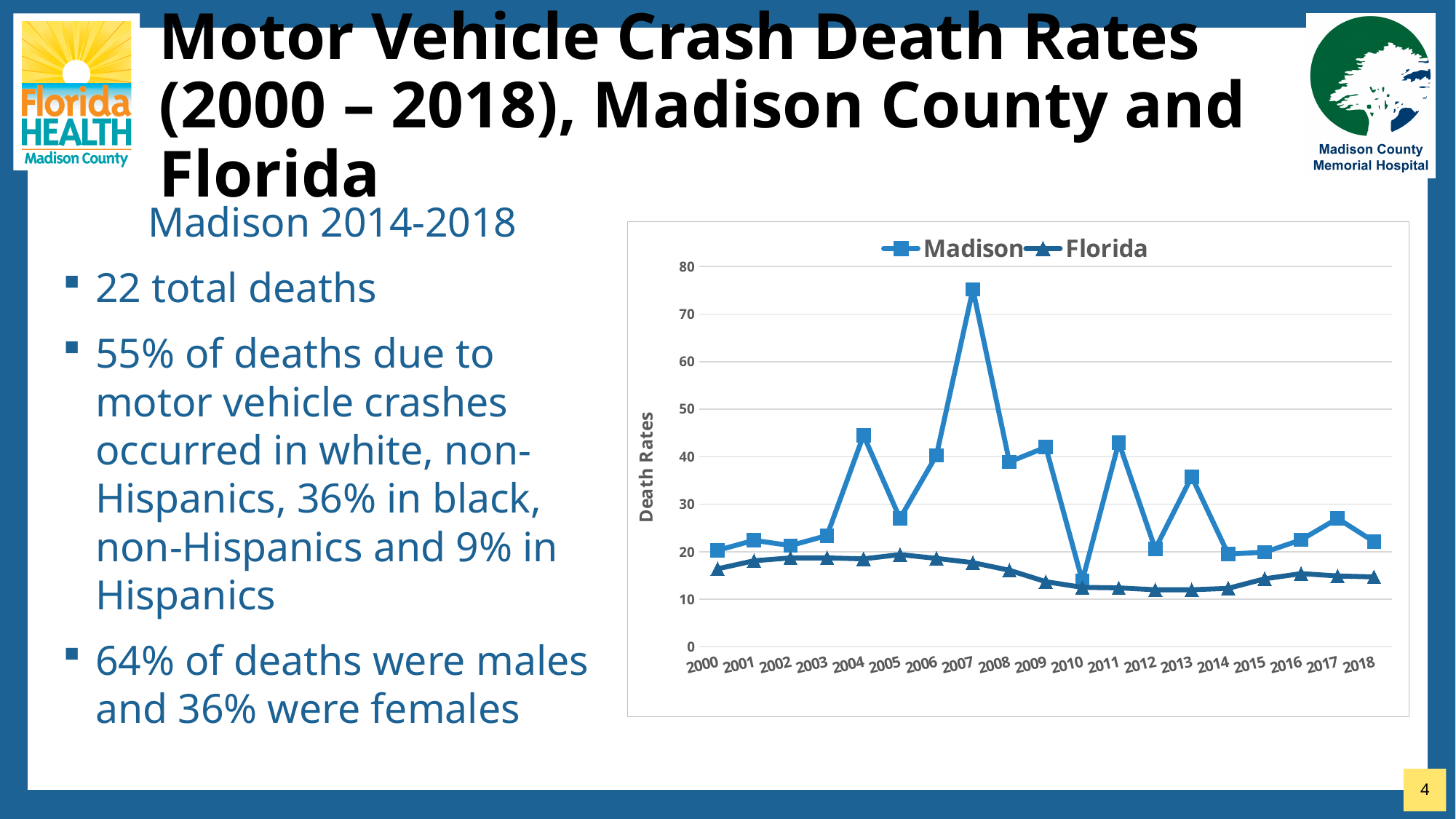
Which series has the higher death rate in 2007, Madison or Florida? Madison How many years are plotted along the x axis of the chart? 19 In which year does the Madison series reach its highest death rate? 2007 What kind of chart is shown on the slide? line chart What is the label on the chart's y axis? Death Rates Is the Madison death rate in 2004 greater or less than 40? greater Does the Florida death rate rise or fall between 2005 and 2012? fall Which series is drawn with triangle markers? Florida How many series does the chart's legend list? 2 Is the Madison death rate in 2007 greater or less than 70? greater In which year does the Madison series reach its lowest death rate? 2010 Is the Florida death rate in 2012 greater or less than 20? less